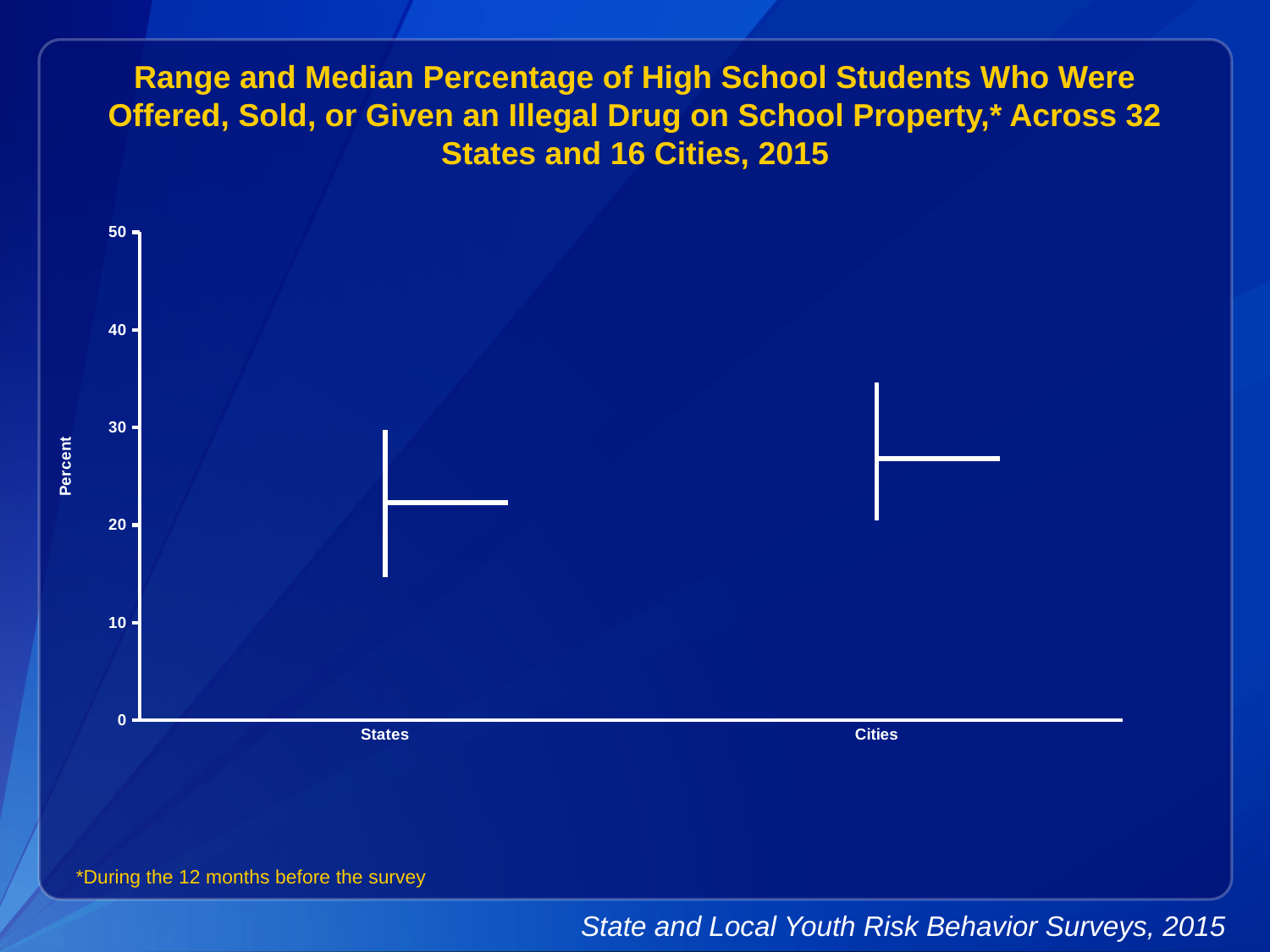
Is the top of the range for Cities greater or less than 30? greater What is the label of the y axis? Percent Is the median value for Cities greater or less than 20? greater How many categories are shown on the x axis of the chart? 2 Is the bottom of the range for States greater or less than 20? less What are the two categories shown on the x axis? States and Cities Which category has the higher top of its range, States or Cities? Cities What is the maximum value shown on the y axis? 50 Which category has the higher median percentage, States or Cities? Cities